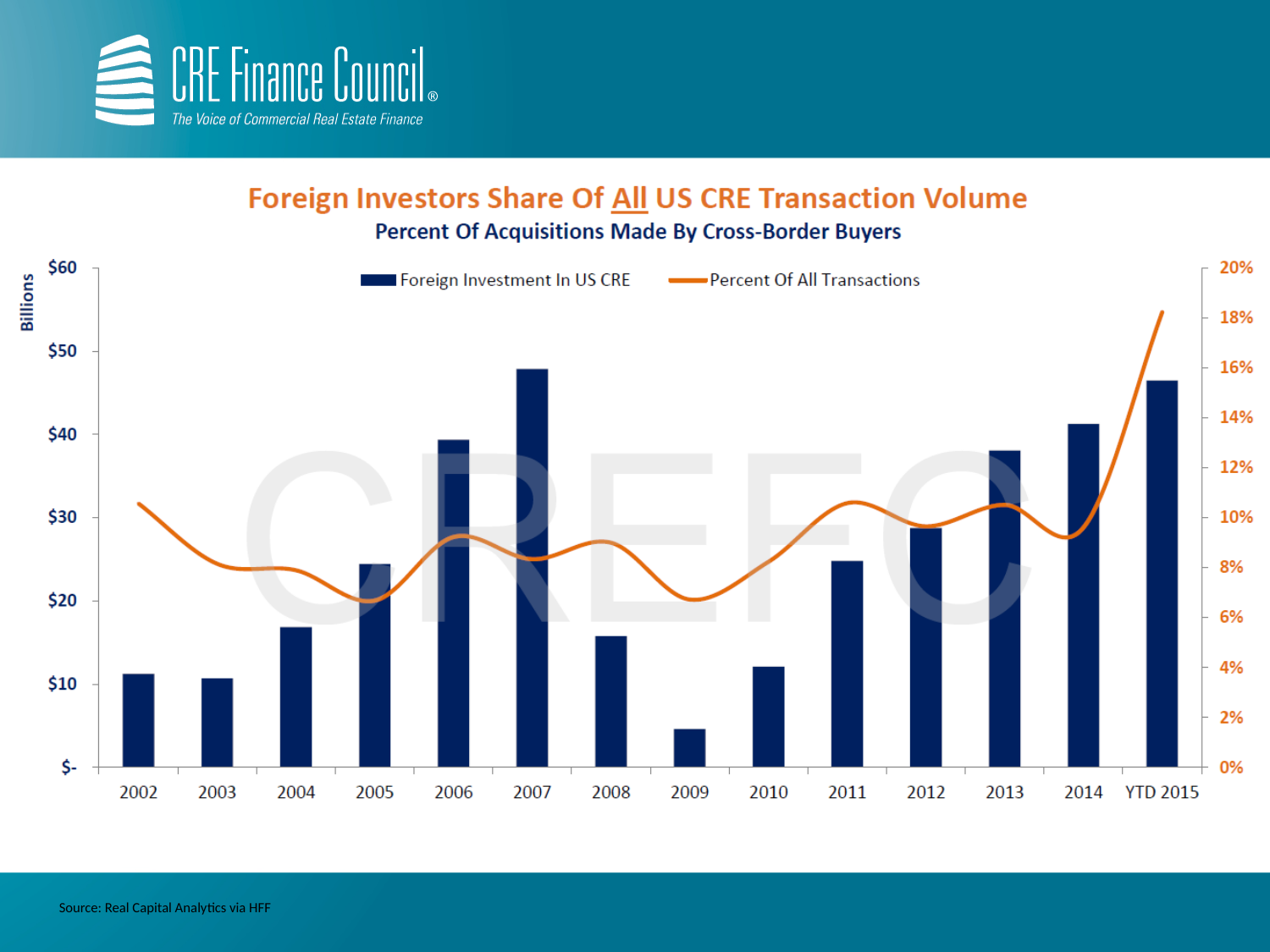
Is the Foreign Investment In US CRE bar for 2009 greater or less than $10 billion? less Do the Foreign Investment In US CRE bars rise or fall from 2009 through YTD 2015? rise How many series does the legend list? 2 Is the Percent Of All Transactions value for YTD 2015 greater or less than 16%? greater Which year has the lowest bar for Foreign Investment In US CRE? 2009 How many years (categories) are shown on the x axis? 14 What is the title of the chart? Foreign Investors Share Of All US CRE Transaction Volume What kind of chart is shown on the slide? A combination bar and line chart In which year does the Percent Of All Transactions line reach its highest point? YTD 2015 Which year has the larger Foreign Investment In US CRE bar, 2006 or 2008? 2006 Is the Percent Of All Transactions value for 2009 greater or less than 8%? less